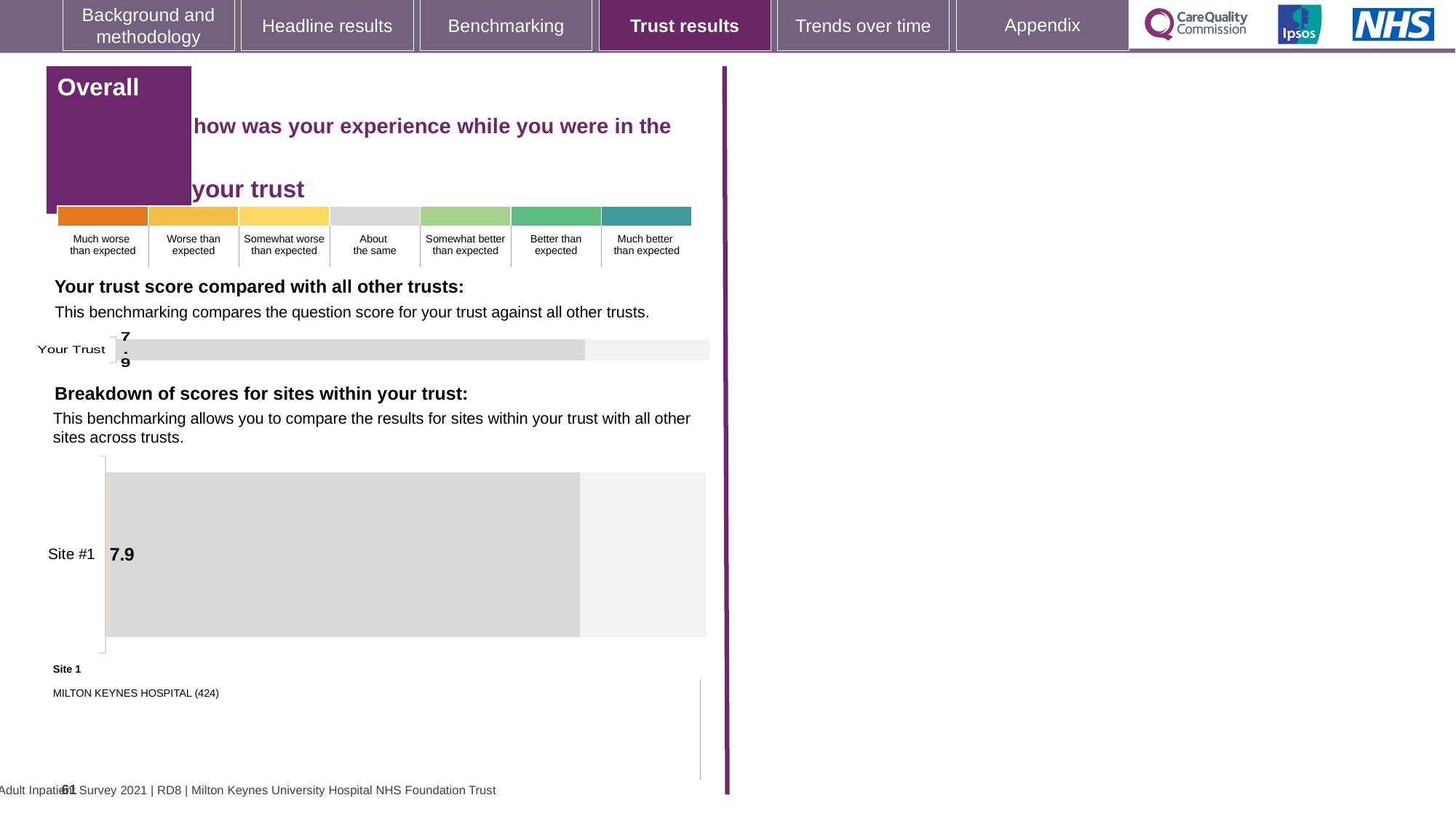
In the 'Your trust score compared with all other trusts' chart, what is the label of the only bar? Your Trust In the 'Your trust score compared with all other trusts' chart, what is the score for Your Trust? 7.9 In the 'Breakdown of scores for sites within your trust' chart, what is the score for Site #1? 7.9 In the 'Breakdown of scores for sites within your trust' chart, what is the label of the only bar? Site #1 What kind of chart is the 'Your trust score compared with all other trusts' chart? bar chart How many sites are plotted in the 'Breakdown of scores for sites within your trust' chart? 1 How many categories are plotted in the 'Your trust score compared with all other trusts' chart? 1 What kind of chart is the 'Breakdown of scores for sites within your trust' chart? bar chart